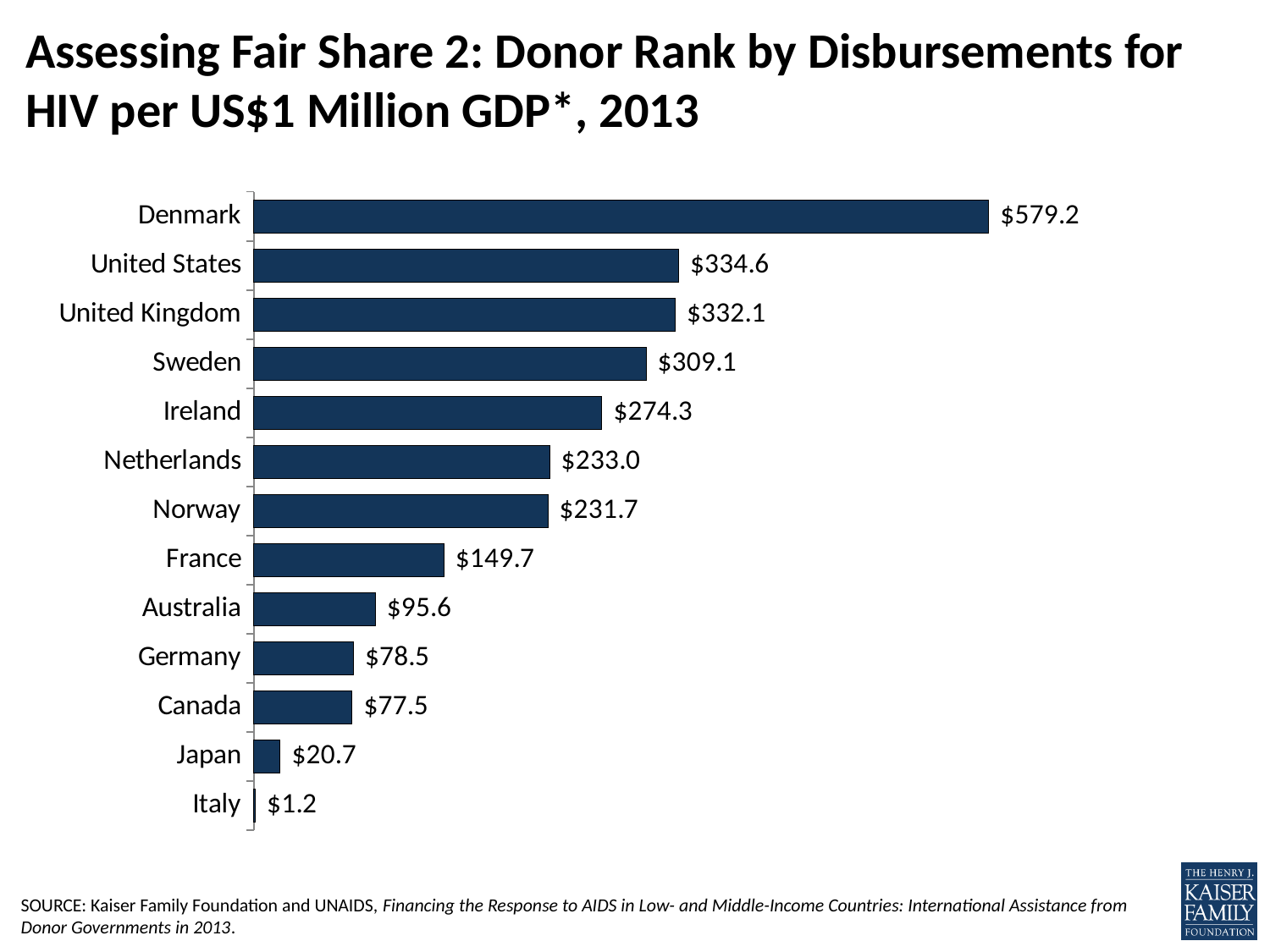
Which country has the highest disbursements for HIV per US$1 million GDP? Denmark What is the value for Denmark? $579.2 What is the difference between the values for Denmark and the United States? $244.6 What is the value for Japan? $20.7 Which is larger, the value for Sweden or the value for Ireland? Sweden What year does the chart title refer to? 2013 Which is larger, the value for Germany or the value for Australia? Australia Which country has the lowest disbursements for HIV per US$1 million GDP? Italy What is the difference between the values for France and Australia? $54.1 What type of chart is shown on the slide? Bar chart What is the value for Ireland? $274.3 How many countries are shown in the chart? 13